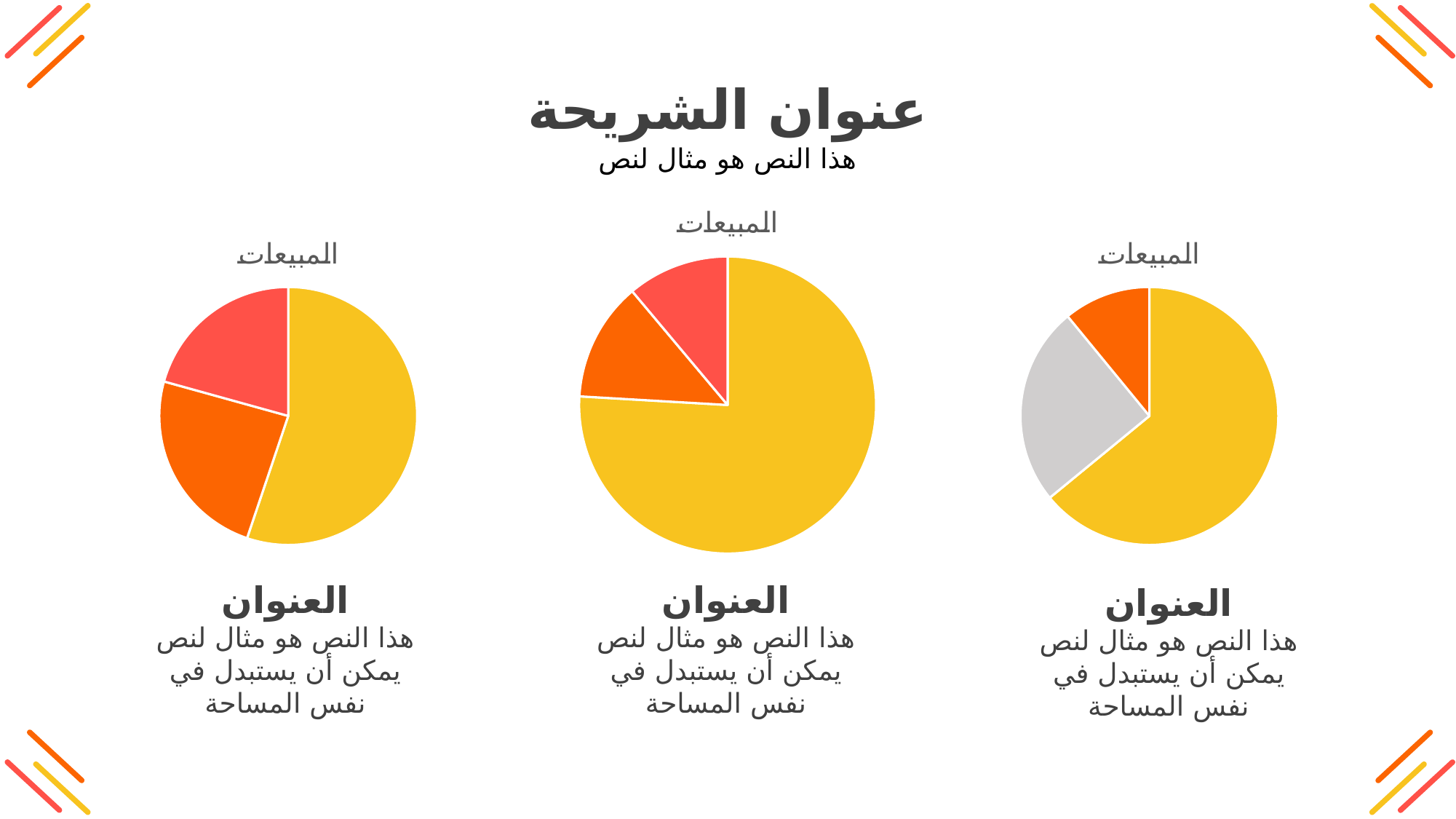
In the left pie chart, which colour slice is the largest? Yellow What kind of chart is the middle chart on the slide? Pie chart How many slices does the middle pie chart have? 3 In the right pie chart, which colour slice is the smallest? Orange How many slices does the right pie chart have? 3 How many pie charts are shown on the slide? 3 What kind of chart is the left chart on the slide? Pie chart In the middle pie chart, which slice is larger, the yellow slice or the red slice? Yellow What is the title of the middle chart? المبيعات In the middle pie chart, which colour slice is the largest? Yellow In the right pie chart, which slice is larger, the grey slice or the orange slice? Grey How many slices does the left pie chart have? 3